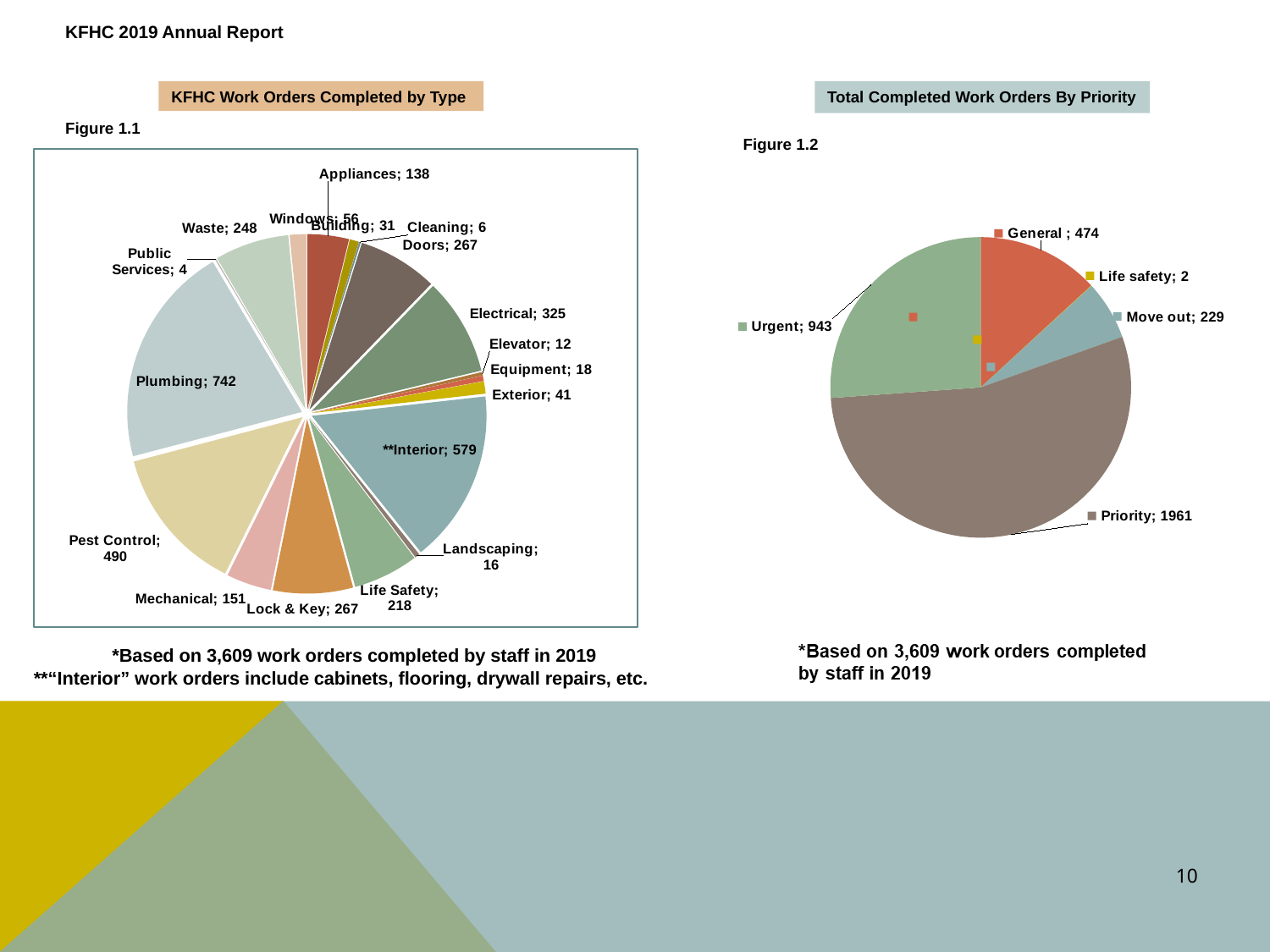
What kind of chart is Figure 1.2, 'Total Completed Work Orders By Priority'? Pie chart In the 'Total Completed Work Orders By Priority' chart (Figure 1.2), which is larger: General or Move out? General In the 'KFHC Work Orders Completed by Type' chart (Figure 1.1), what is the difference between the Interior and Electrical work order counts? 254 In the 'Total Completed Work Orders By Priority' chart (Figure 1.2), how many work orders were in the Urgent category? 943 In the 'Total Completed Work Orders By Priority' chart (Figure 1.2), what is the difference between the Priority and Urgent counts? 1018 In the 'KFHC Work Orders Completed by Type' chart (Figure 1.1), how many work orders were completed for Plumbing? 742 In the 'Total Completed Work Orders By Priority' chart (Figure 1.2), which priority category has the most completed work orders? Priority In the 'KFHC Work Orders Completed by Type' chart (Figure 1.1), how many work orders were completed for Pest Control? 490 In the 'Total Completed Work Orders By Priority' chart (Figure 1.2), which priority category has the fewest completed work orders? Life safety In the 'KFHC Work Orders Completed by Type' chart (Figure 1.1), which type has the lowest number of completed work orders? Public Services In the 'KFHC Work Orders Completed by Type' chart (Figure 1.1), how many work order types are shown? 18 In the 'KFHC Work Orders Completed by Type' chart (Figure 1.1), which type has the highest number of completed work orders? Plumbing